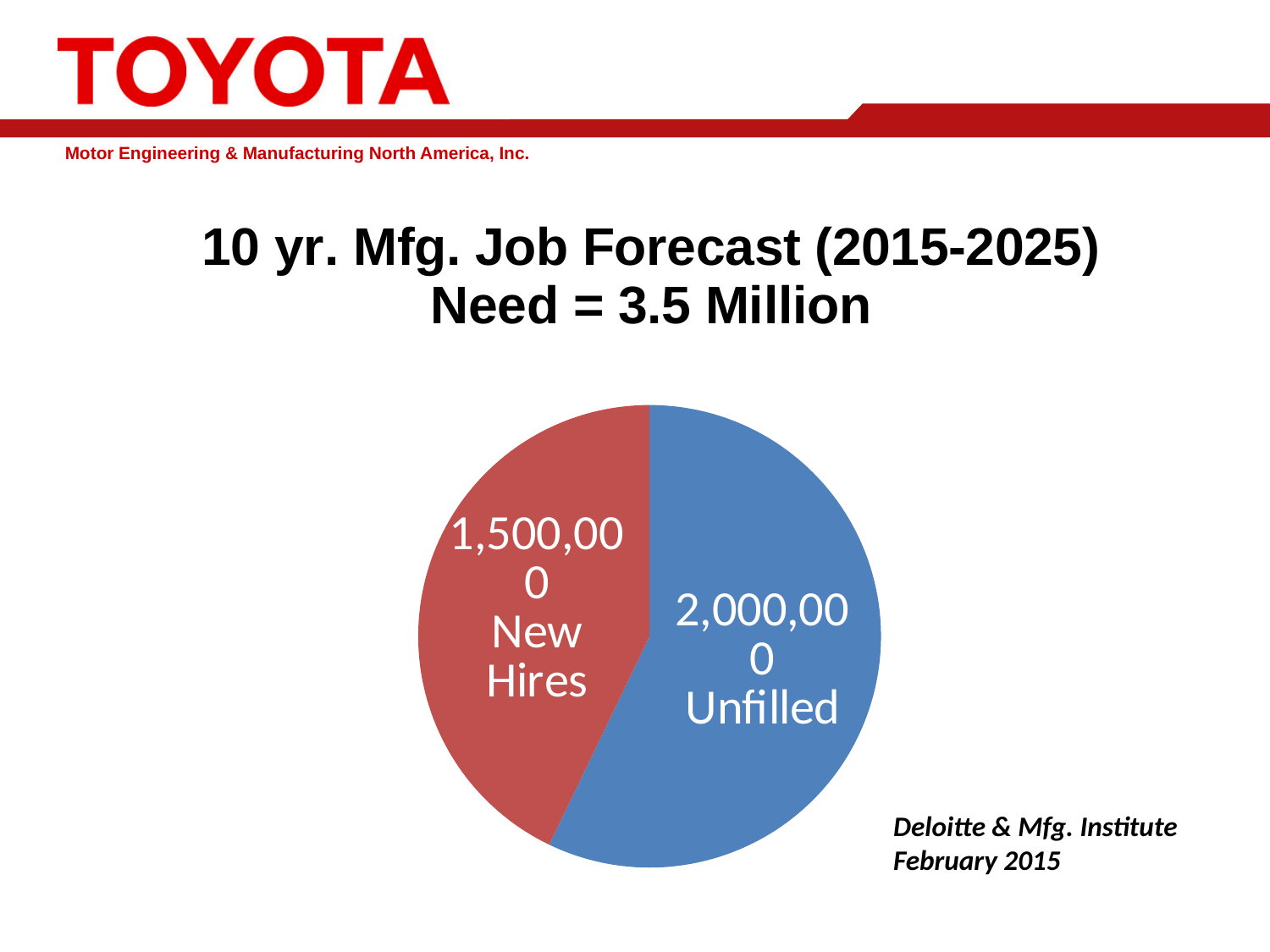
How many slices does the pie chart have? 2 What is the value of the Unfilled slice in the pie chart? 2,000,000 What is the total of the two slices in the pie chart? 3,500,000 What is the value of the New Hires slice in the pie chart? 1,500,000 What is the difference between the Unfilled and New Hires values in the pie chart? 500,000 To the nearest whole percent, what share of the pie does the Unfilled slice represent? 57% What colour is the Unfilled slice in the pie chart? Blue What kind of chart is shown on the slide? Pie chart Which is larger in the pie chart, Unfilled or New Hires? Unfilled Which slice of the pie chart is the largest? Unfilled Which slice of the pie chart is the smallest? New Hires What is the title of the chart on the slide? 10 yr. Mfg. Job Forecast (2015-2025) Need = 3.5 Million